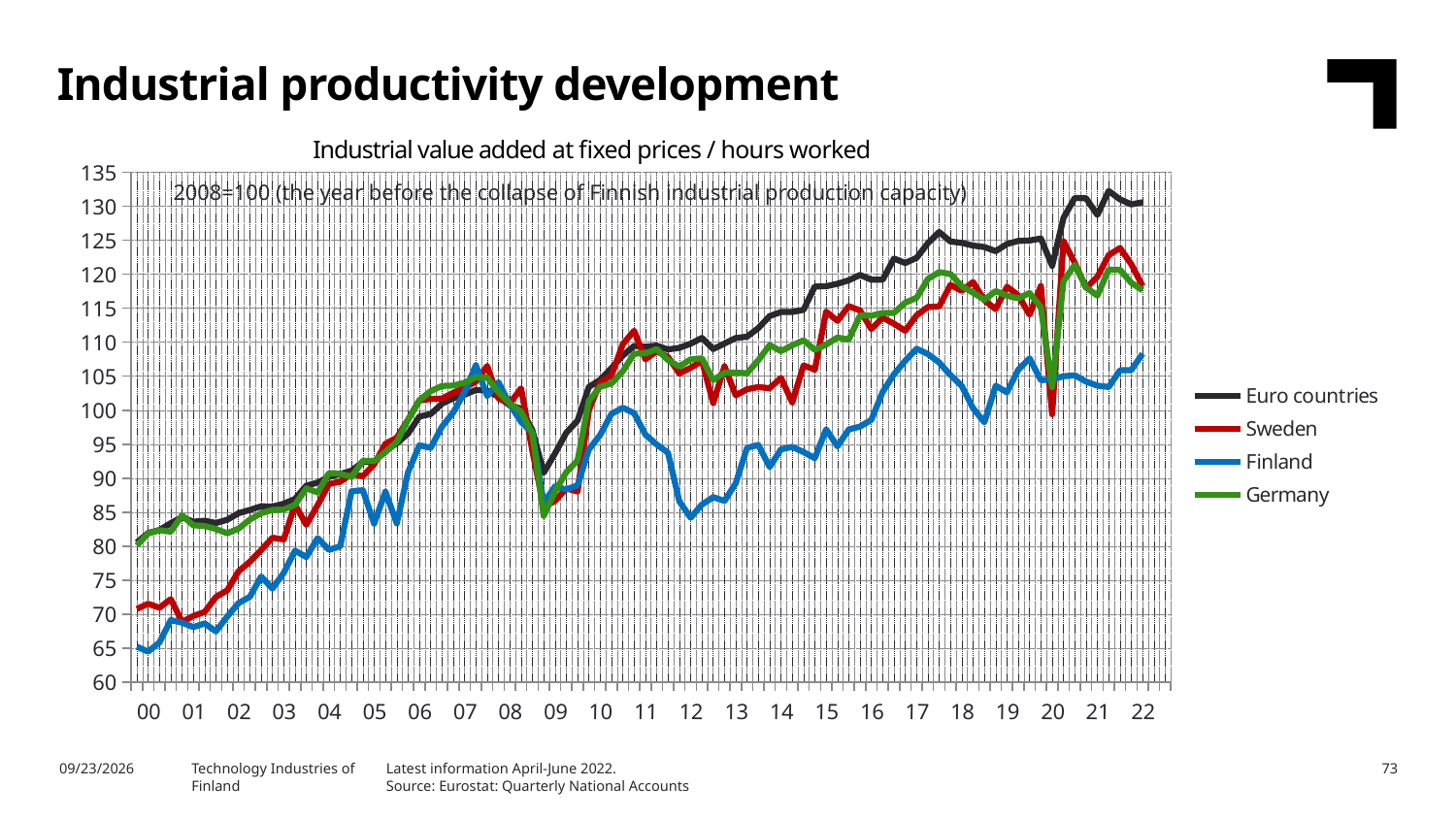
Is the value for Finland at the end of 2022 greater or less than 100? greater Which series has the lowest value at the start of the chart in 2000? Finland What kind of chart is shown on the slide? Line chart Which series has the highest value at the end of the chart in 2022? Euro countries Which series has the lowest value at the end of the chart in 2022? Finland In 2012, which is higher, Germany or Finland? Germany Is the value for Finland in 2012 greater or less than 90? less How many series does the legend list? 4 Is the peak value for Euro countries in 2021 greater or less than 130? greater Does the Euro countries series generally rise or fall from 2000 to 2022? Rise Which base year is set to 100 in the chart? 2008 Which series is plotted in blue? Finland